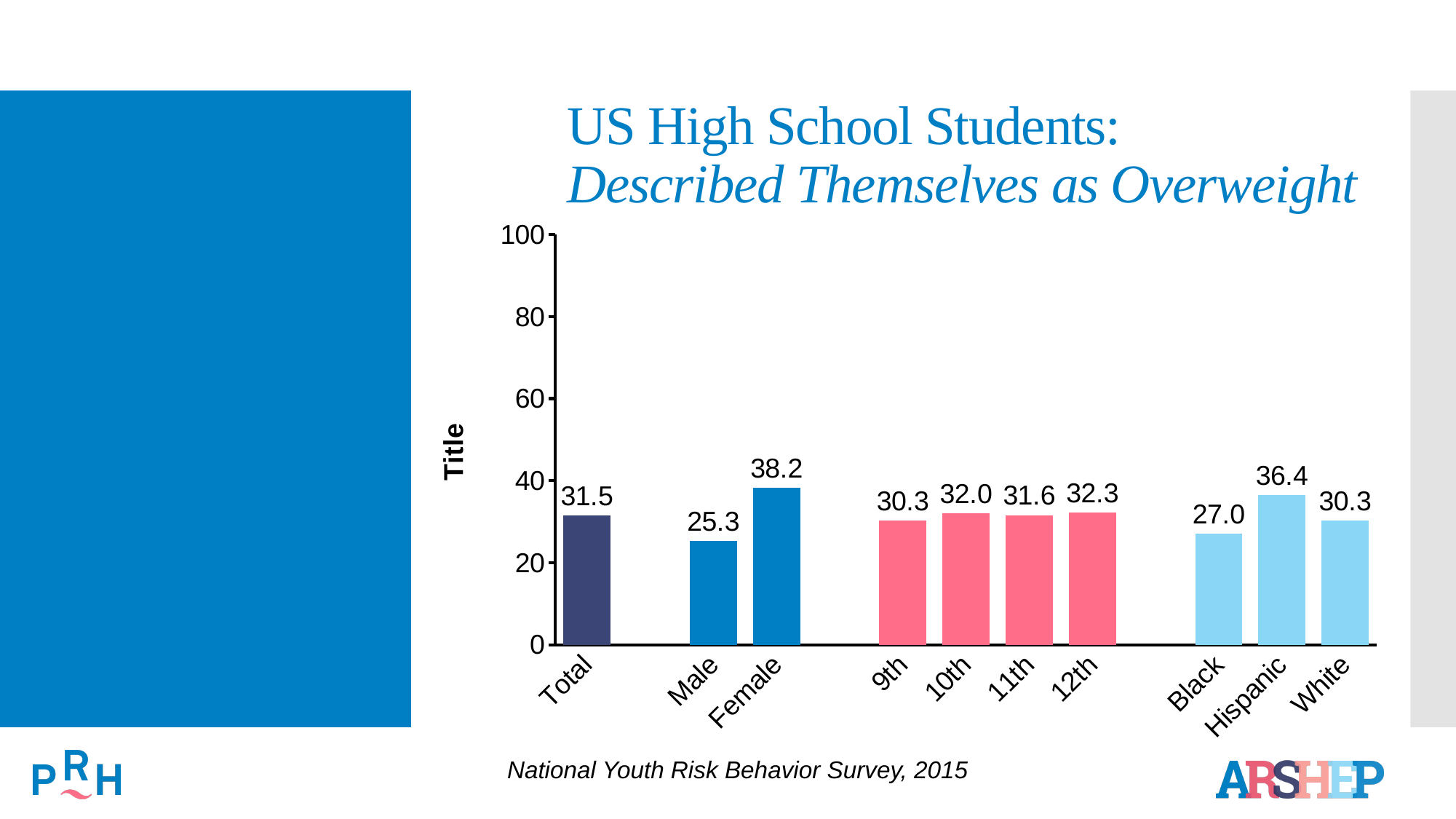
What is the value for Hispanic? 36.4 What kind of chart is shown on the slide? bar chart Is the value for Male greater or less than 40? less What is the value for Female? 38.2 How many categories are shown on the x axis? 10 What is the difference between the values for Female and Male? 12.9 What is the value for 10th? 32.0 Which is larger, the value for Hispanic or the value for White? Hispanic What is the difference between the values for Hispanic and Black? 9.4 Which category has the lowest value? Male What is the value for Total? 31.5 Which category has the highest value? Female